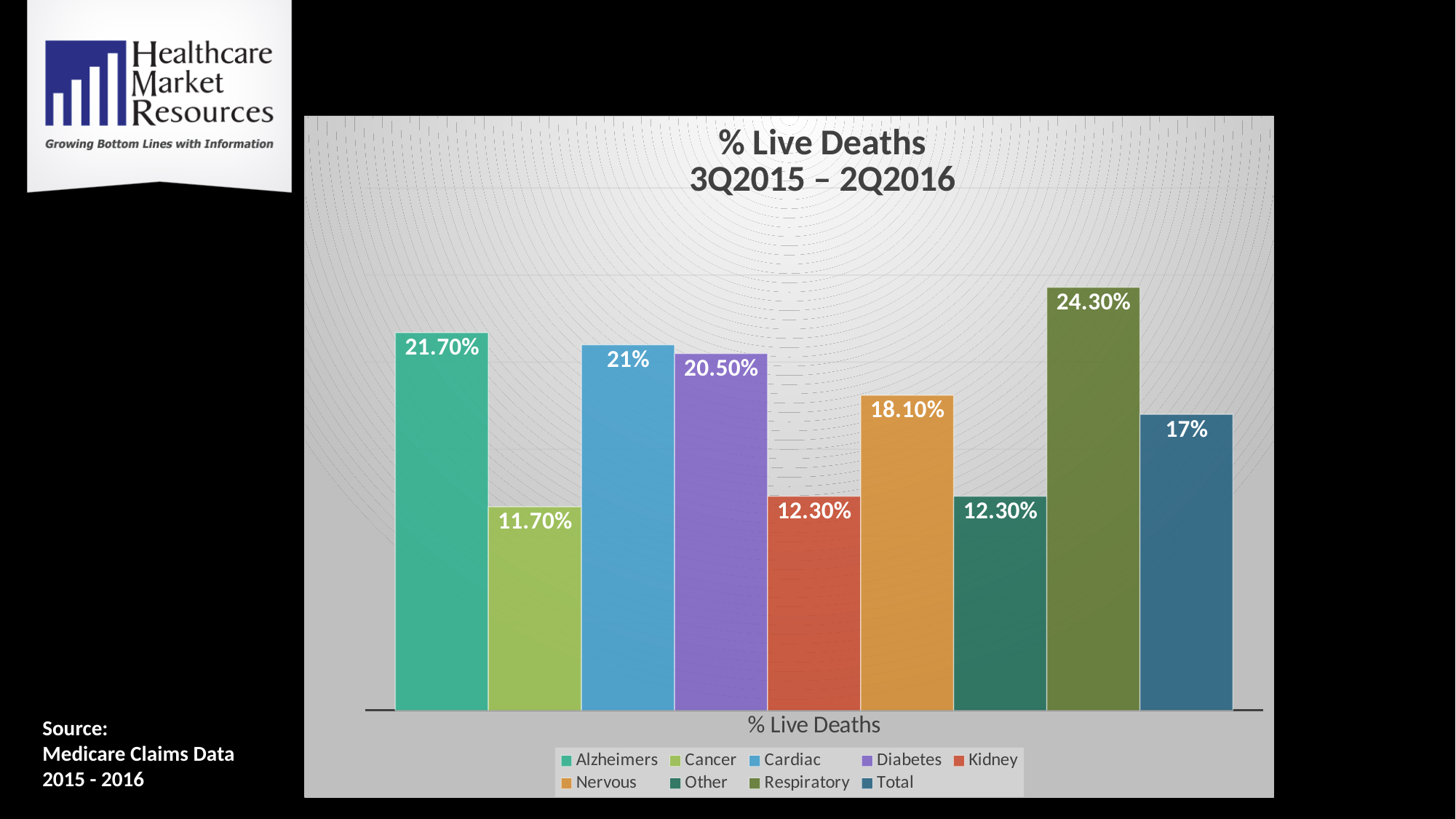
Which series has the lowest % Live Deaths? Cancer Which series has the highest % Live Deaths? Respiratory How many series does the legend list? 9 What is the % Live Deaths value for Total? 17% What kind of chart is shown on the slide? Bar chart What is the title of the chart? % Live Deaths 3Q2015 – 2Q2016 Which is larger, the value for Cardiac or the value for Diabetes? Cardiac What is the difference between the Respiratory and Cancer values? 12.60% What is the % Live Deaths value for Alzheimers? 21.70% What is the % Live Deaths value for Cancer? 11.70% What is the % Live Deaths value for Respiratory? 24.30% What is the difference between the Alzheimers and Total values? 4.70%